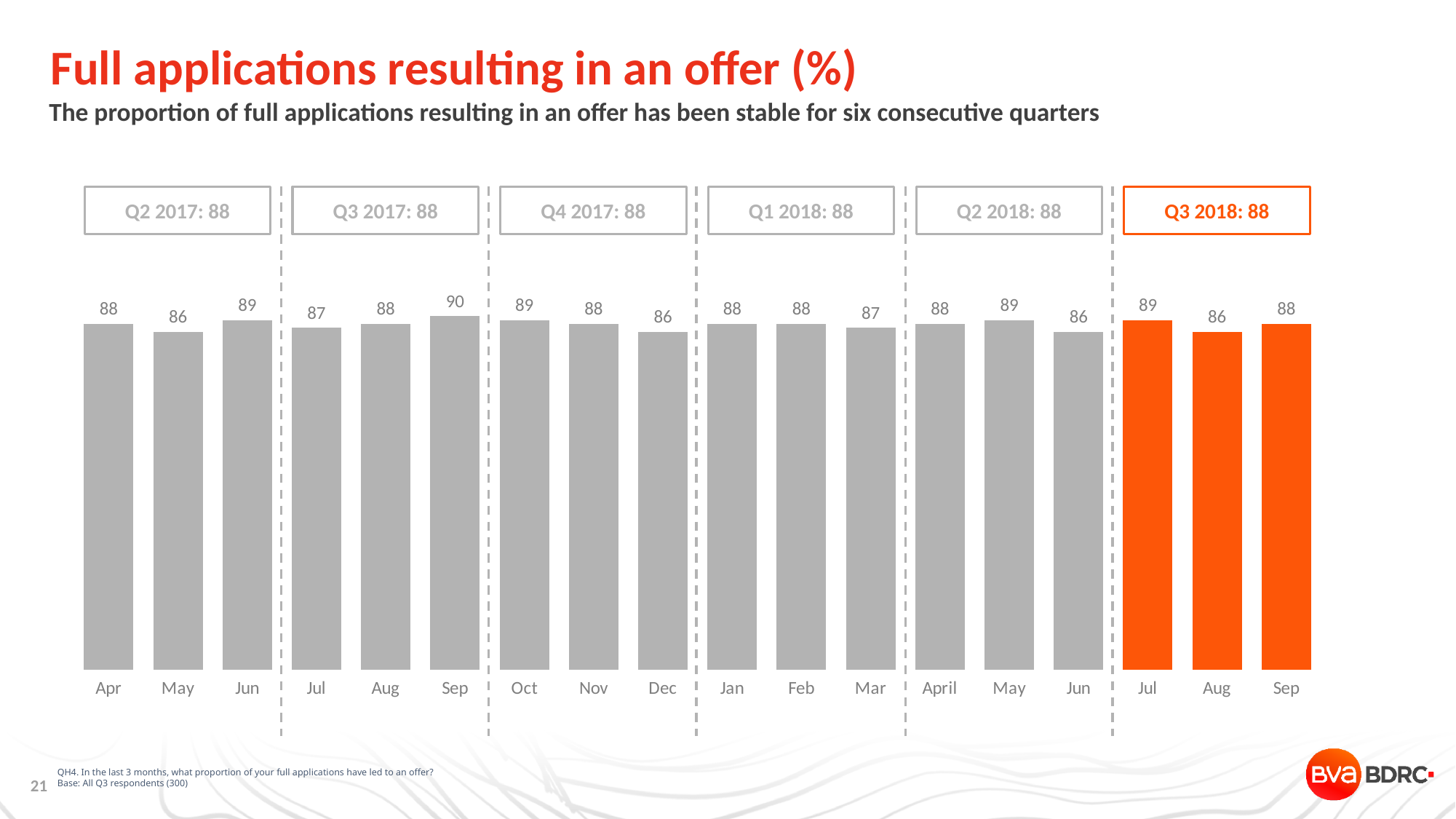
How many monthly bars are plotted on the chart? 18 Which is larger, the value for Jul in Q3 2017 or the value for Jul in Q3 2018? Jul in Q3 2018 What type of chart is shown on the slide? bar chart Which quarter's bars are highlighted in orange? Q3 2018 Which month has the highest value on the chart? Sep (Q3 2017) What is the value for Dec in Q4 2017? 86 What is the lowest monthly value shown on the chart? 86 What is the value for Mar in Q1 2018? 87 What is the value for Aug in Q3 2018? 86 What is the difference between the value for Sep in Q3 2017 and the value for Aug in Q3 2018? 4 What is the value for Sep in Q3 2017? 90 What is the quarterly figure shown in the box for Q3 2018? 88